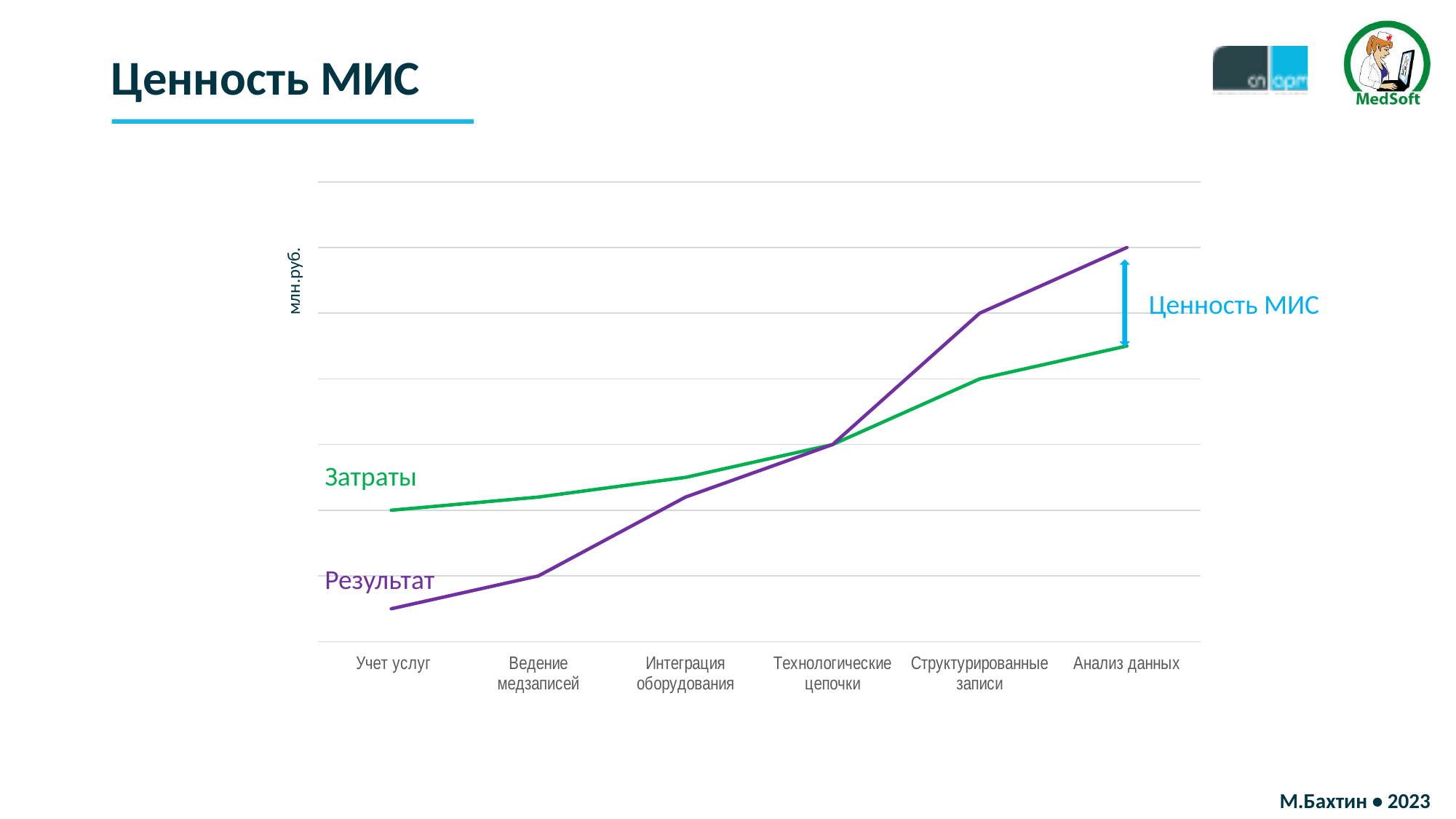
What unit is shown on the y axis label? млн.руб. Does the Затраты line rise or fall along the x axis? rises At Анализ данных, which is larger: Затраты or Результат? Результат What kind of chart is shown on the slide? line chart For which category is the Результат value highest? Анализ данных How many categories are shown along the x axis? 6 How many data series are plotted on the chart? 2 For which category is the Результат value lowest? Учет услуг For which category is the Затраты value lowest? Учет услуг What colour is the Затраты line? green Does the Результат line rise or fall from Учет услуг to Анализ данных? rises At Учет услуг, which is larger: Затраты or Результат? Затраты